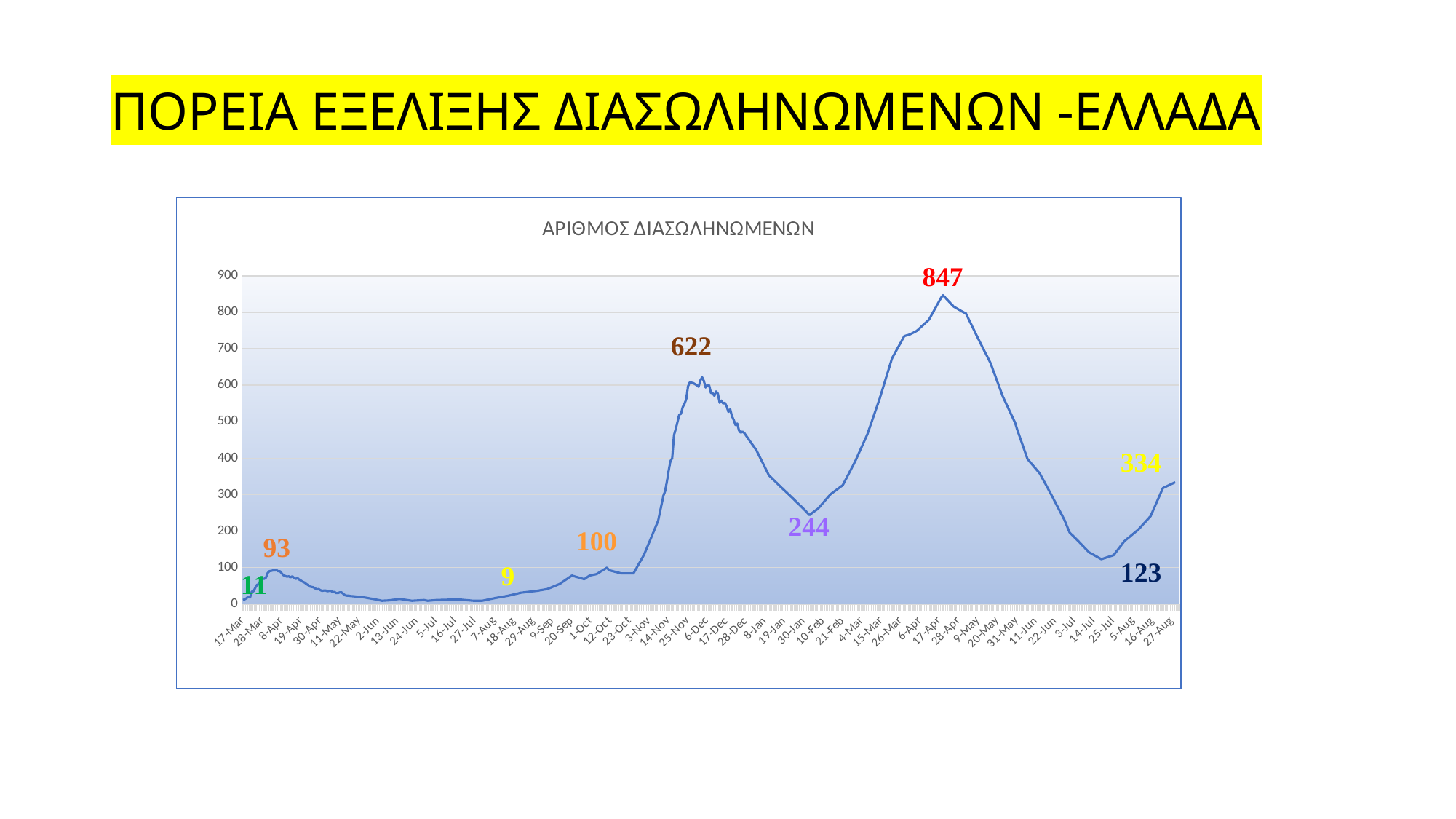
What is the title of the chart? ΑΡΙΘΜΟΣ ΔΙΑΣΩΛΗΝΩΜΕΝΩΝ Is the value at 27-Aug greater or less than 300? greater What is the highest value labelled on the chart? 847 Which labelled peak is larger, the one in December (622) or the one in April (847)? 847 (April) What is the difference between the labelled peak of 847 and the labelled peak of 622? 225 What value is labelled at the trough around late January? 244 What is the difference between the labelled values 334 and 123? 211 What kind of chart is shown on the slide? line chart What value is labelled at the peak around early December? 622 What value is labelled at the end of the line, around 27-Aug? 334 Does the line rise or fall between 28-Apr and 25-Jul? fall What is the lowest value labelled on the chart? 9